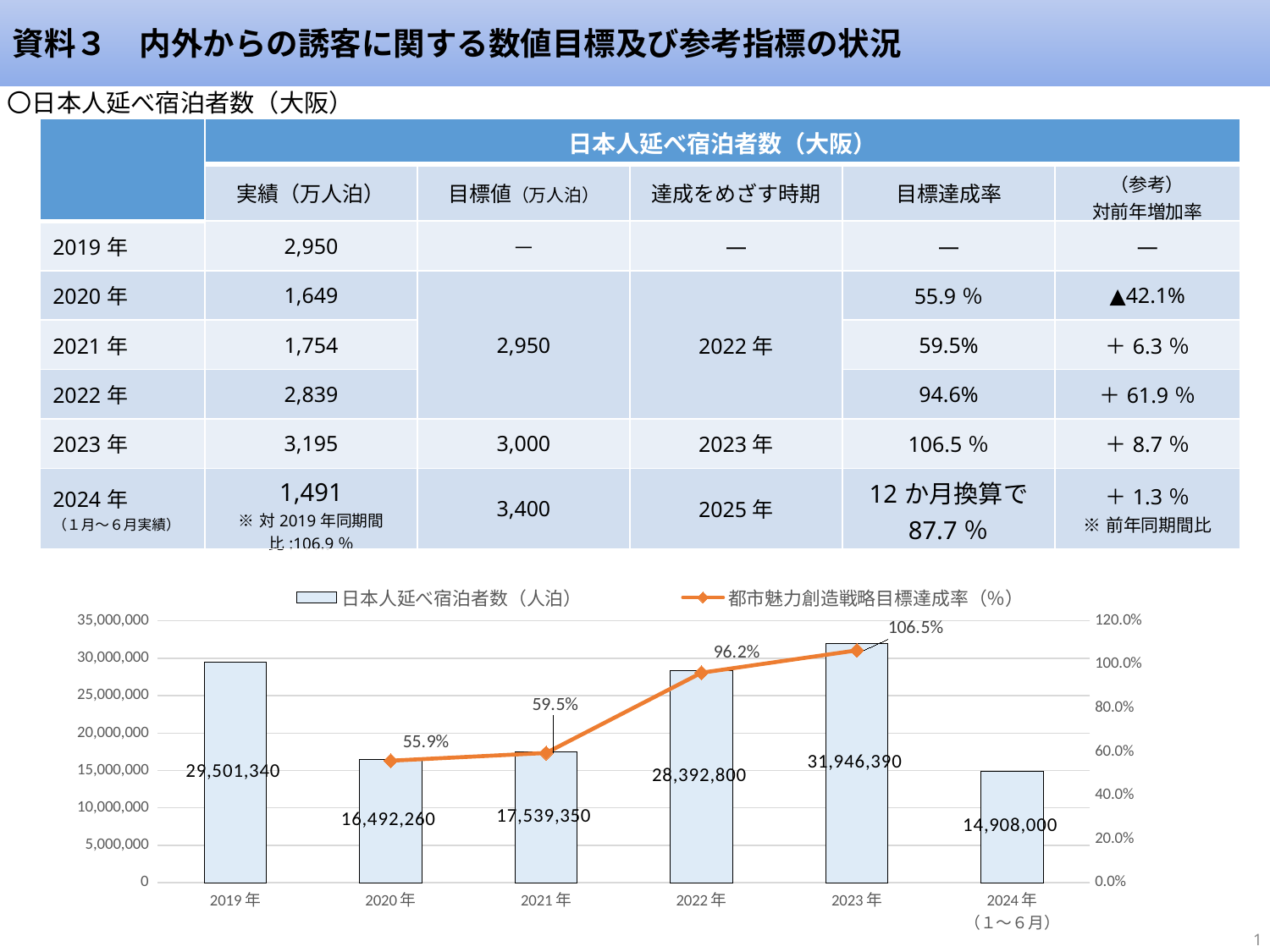
How many series does the chart legend list? 2 In the chart, which category has the lowest 日本人延べ宿泊者数（人泊）? 2024年（1～6月） In the chart, what is the value of 日本人延べ宿泊者数（人泊） for 2019年? 29,501,340 In the chart, which year has the highest 日本人延べ宿泊者数（人泊）? 2023年 In the chart, what is the 都市魅力創造戦略目標達成率（%） for 2020年? 55.9% In the chart, what is the difference in 日本人延べ宿泊者数（人泊） between 2023年 and 2022年? 3,553,590 In the chart, is the 日本人延べ宿泊者数（人泊） for 2022年 greater or less than 25,000,000? greater Does the 都市魅力創造戦略目標達成率（%） line rise or fall from 2020年 to 2023年? rise In the chart, what is the value of 日本人延べ宿泊者数（人泊） for 2023年? 31,946,390 In the chart, which is larger, the 日本人延べ宿泊者数（人泊） for 2020年 or for 2021年? 2021年 How many categories are shown on the x axis of the chart? 6 In the chart, what is the 都市魅力創造戦略目標達成率（%） for 2022年? 96.2%